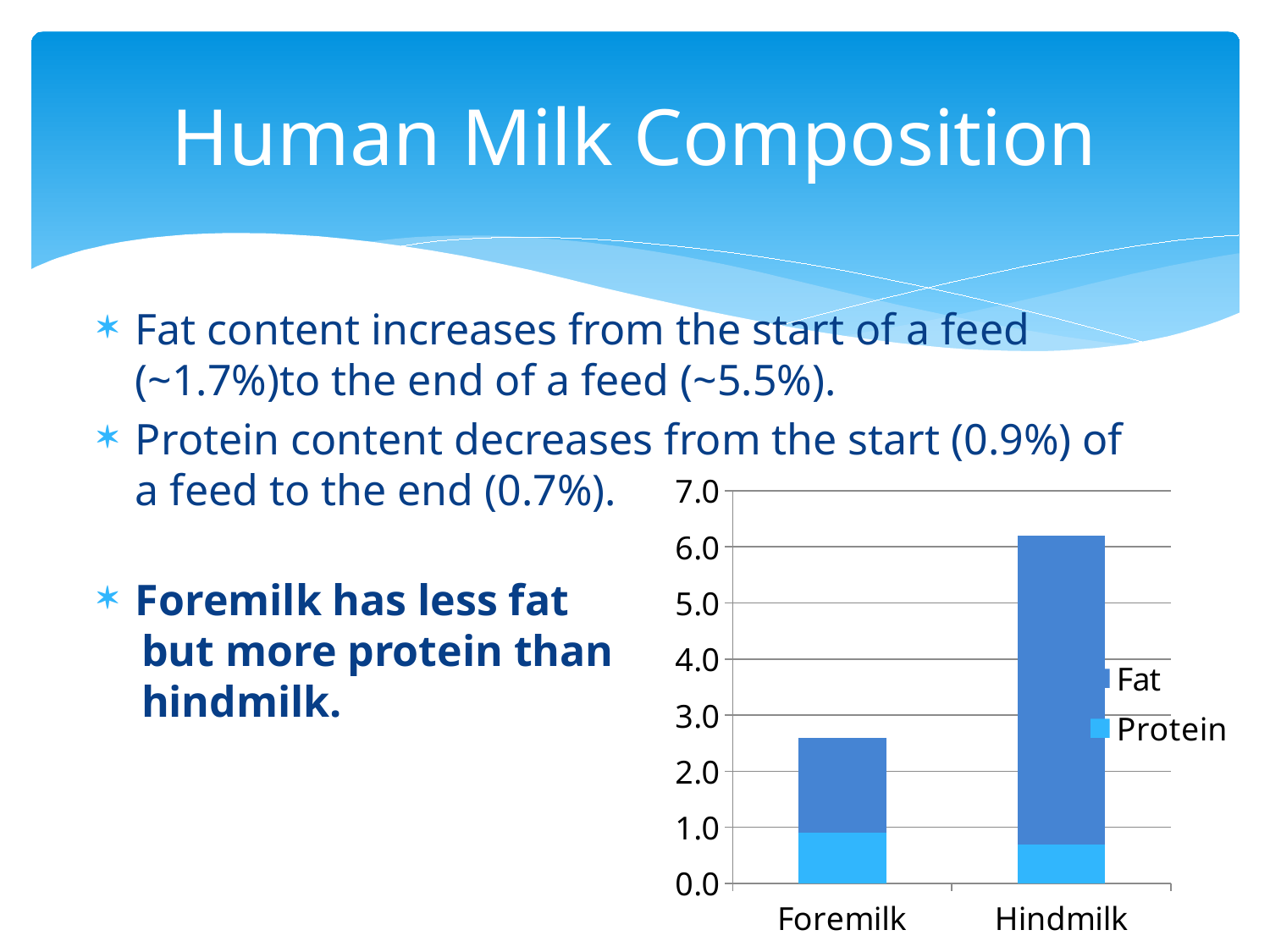
How many categories are shown on the x axis of the chart? 2 Is the total bar height for Hindmilk greater or less than 5.0? greater Is the total bar height for Foremilk greater or less than 3.0? less Which two series are listed in the chart's legend? Fat and Protein What is the highest value shown on the chart's vertical axis? 7.0 Which category has the larger Fat segment, Foremilk or Hindmilk? Hindmilk How many series does the chart's legend list? 2 Which category has the highest total bar height? Hindmilk Which category has the lowest total bar height? Foremilk Which category has the taller stacked bar, Foremilk or Hindmilk? Hindmilk What kind of chart is shown on the slide? stacked bar chart